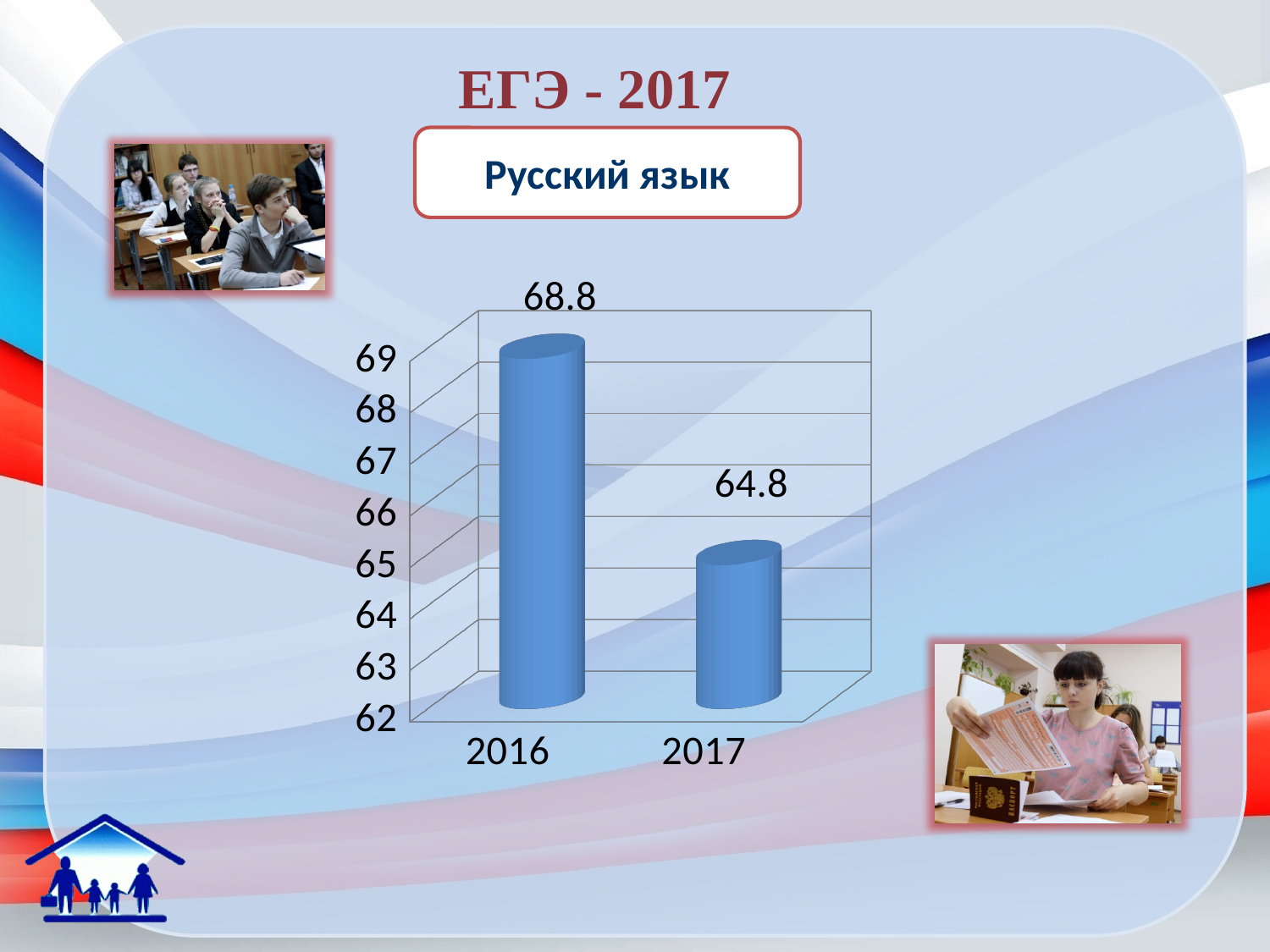
Is the value for 2016 greater or less than 68? greater What subject is named in the box above the chart? Русский язык Which year has the lowest value? 2017 Is the value for 2017 greater or less than 66? less What is the value for 2017? 64.8 What is the value for 2016? 68.8 What kind of chart is shown on the slide? bar chart Which is larger, the value for 2016 or the value for 2017? 2016 Which year has the highest value? 2016 What is the difference between the values for 2016 and 2017? 4 Do the values rise or fall from 2016 to 2017? fall How many categories are shown on the x axis? 2